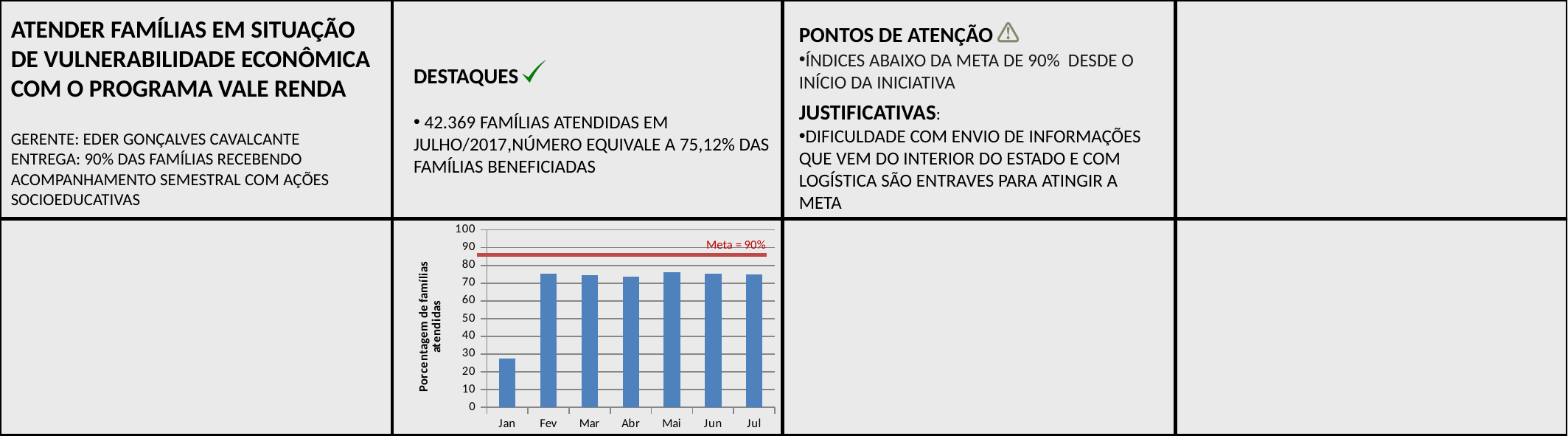
Is the value for Jul greater or less than 80? less How many months are plotted on the x axis of the chart? 7 Is the value for Fev greater or less than 70? greater What target value is marked by the red line in the chart? Meta = 90% Which is larger, the value for Jan or the value for Fev? Fev Is the value for Mai greater or less than 60? greater Which month has the lowest value in the chart? Jan What kind of chart is shown on the slide? bar chart What is the title of the y axis of the chart? Porcentagem de famílias atendidas Which is larger, the value for Abr or the value for Jan? Abr